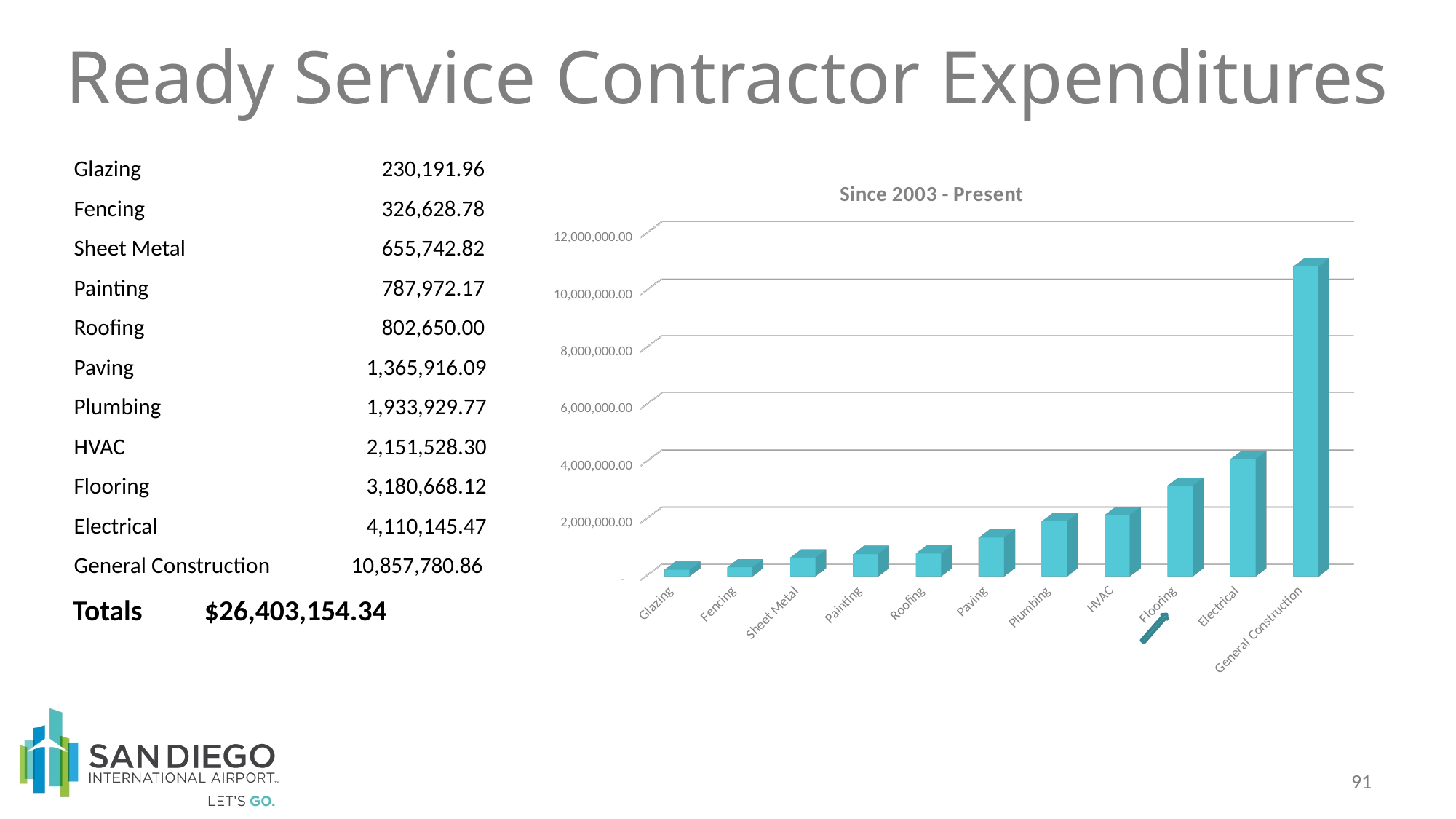
What is the expenditure value for Flooring? 3,180,668.12 Which is larger, the value for Plumbing or the value for Paving? Plumbing Which category has the lowest expenditure on the chart? Glazing Is the value for Electrical greater or less than 4,000,000.00? greater Which category has the highest expenditure on the chart? General Construction Do the bar values rise or fall moving left to right along the x axis? rise What kind of chart is shown on the slide? bar chart How many categories are plotted on the chart? 11 What is the title of the chart? Since 2003 - Present Is the value for HVAC greater or less than 4,000,000.00? less What is the difference between the Electrical and Flooring expenditures? 929,477.35 What is the expenditure value for General Construction? 10,857,780.86